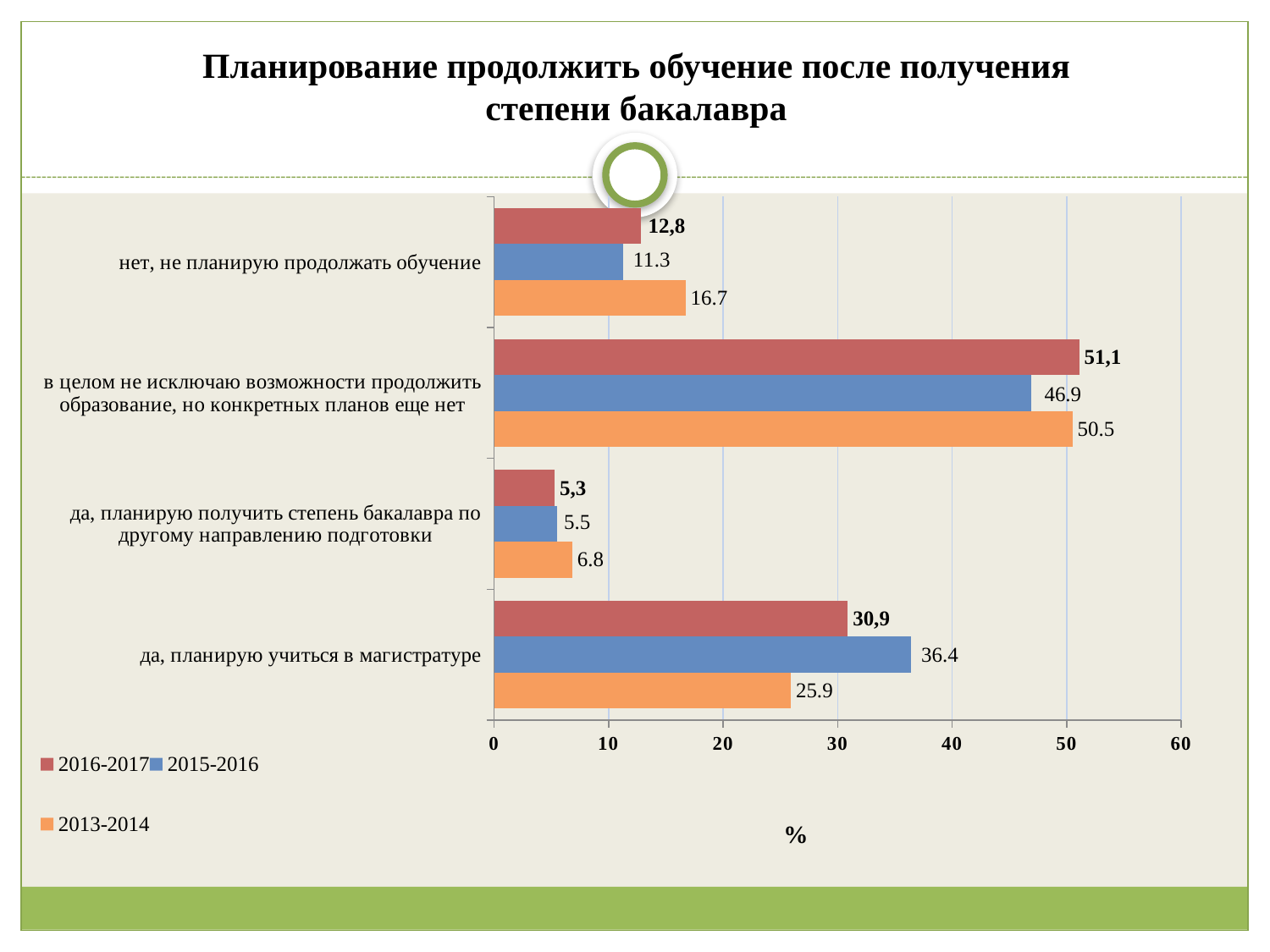
What is the difference between the 2015-2016 and 2013-2014 values for "да, планирую учиться в магистратуре"? 10.5 How many series does the legend list? 3 For "да, планирую учиться в магистратуре", which is larger: the 2016-2017 value or the 2013-2014 value? 2016-2017 What kind of chart is shown on the slide? bar chart What is the difference between the 2013-2014 and 2015-2016 values for "нет, не планирую продолжать обучение"? 5.4 How many categories are shown on the chart? 4 What is the 2015-2016 value for "да, планирую учиться в магистратуре"? 36.4 Which category has the highest 2015-2016 value? в целом не исключаю возможности продолжить образование, но конкретных планов еще нет What is the 2016-2017 value for "в целом не исключаю возможности продолжить образование, но конкретных планов еще нет"? 51,1 What is the 2013-2014 value for "нет, не планирую продолжать обучение"? 16.7 Which category has the lowest 2013-2014 value? да, планирую получить степень бакалавра по другому направлению подготовки What is the 2013-2014 value for "да, планирую получить степень бакалавра по другому направлению подготовки"? 6.8